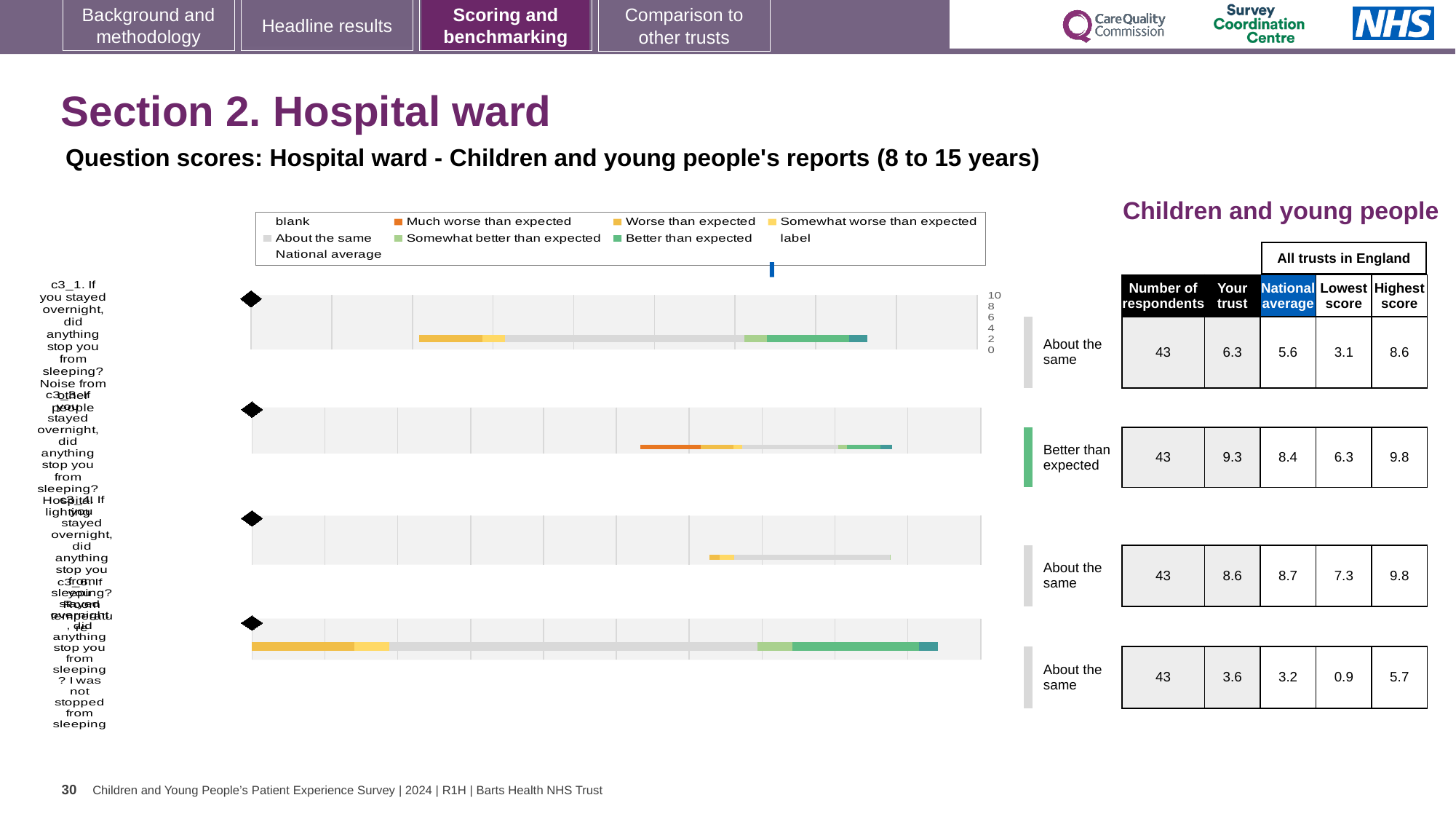
In the legend above the charts, which colour represents 'Much worse than expected'? orange In the table to the right of the charts, what is the 'Your trust' score for the second row (Better than expected)? 9.3 In the table to the right of the charts, what is the 'National average' for the fourth (bottom) row? 3.2 In the table to the right of the charts, what is the difference between 'Your trust' and 'National average' for the second row (Better than expected)? 0.9 In the table to the right of the charts, which row has the highest 'Your trust' score? Better than expected (9.3) In the table to the right of the charts, what is the 'Number of respondents' for the first row? 43 What kind of chart is used for the question scores on this slide? bar chart How many entries does the legend above the charts list? 9 What is the maximum value shown on the axis of the top bar chart? 10 How many separate bar charts are shown on the slide? 4 In the table to the right of the charts, what is the 'Lowest score' for the fourth (bottom) row? 0.9 In the table to the right of the charts, for the third row, which is larger: 'Your trust' or 'National average'? National average